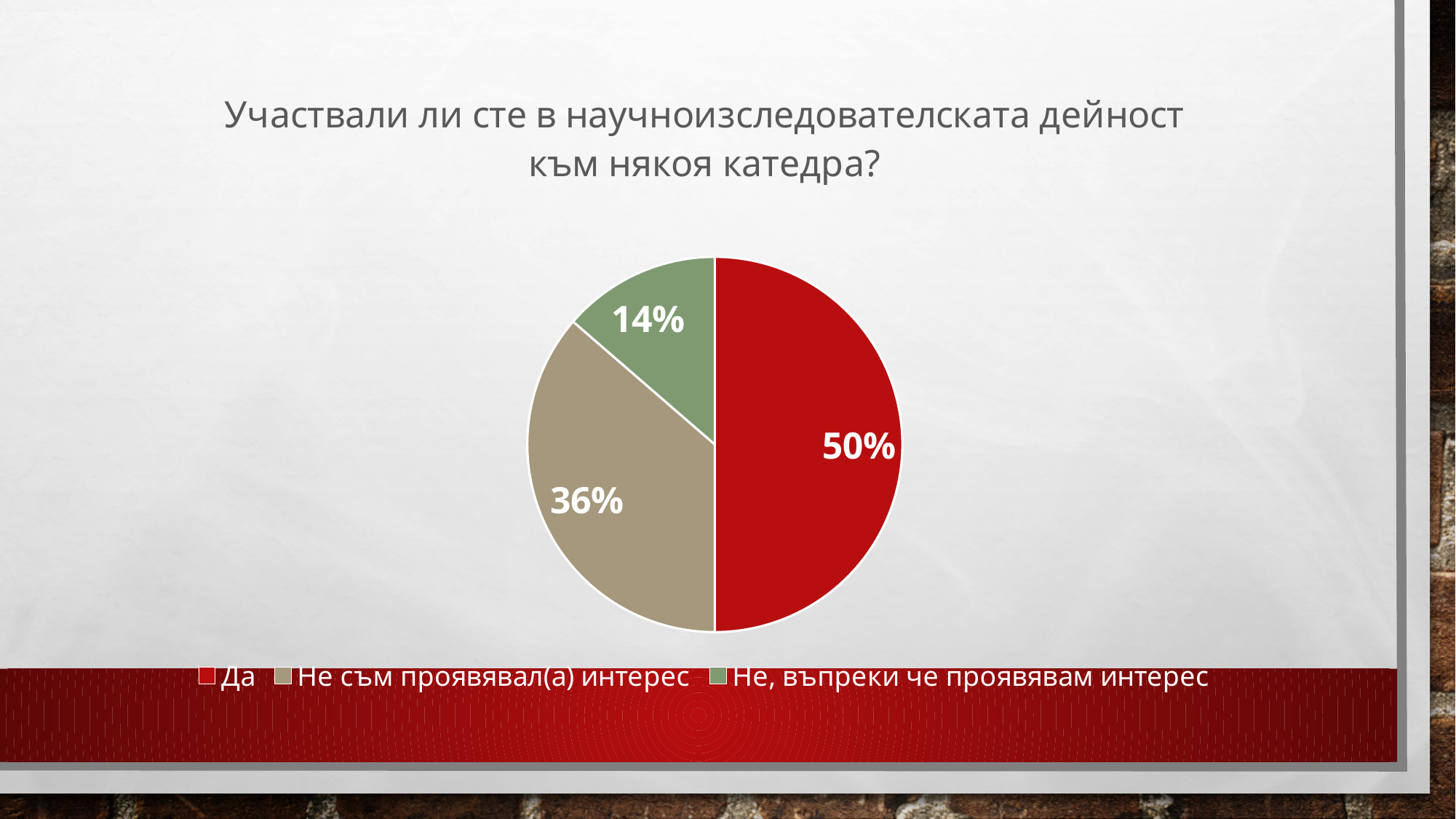
What is the difference in percentage points between the "Да" slice and the "Не съм проявявал(а) интерес" slice? 14 What share of the pie does the "Да" slice represent? 50% What share of the pie does the "Не, въпреки че проявявам интерес" slice represent? 14% What is the difference in percentage points between the "Не съм проявявал(а) интерес" slice and the "Не, въпреки че проявявам интерес" slice? 22 What share of the pie does the "Не съм проявявал(а) интерес" slice represent? 36% Which category has the smallest slice of the pie? Не, въпреки че проявявам интерес How many slices does the pie chart have? 3 Which is larger: the "Не съм проявявал(а) интерес" slice or the "Не, въпреки че проявявам интерес" slice? Не съм проявявал(а) интерес What is the title of the chart? Участвали ли сте в научноизследователската дейност към някоя катедра? What kind of chart is shown on the slide? Pie chart What colour is the "Да" slice? Red Which category has the largest slice of the pie? Да